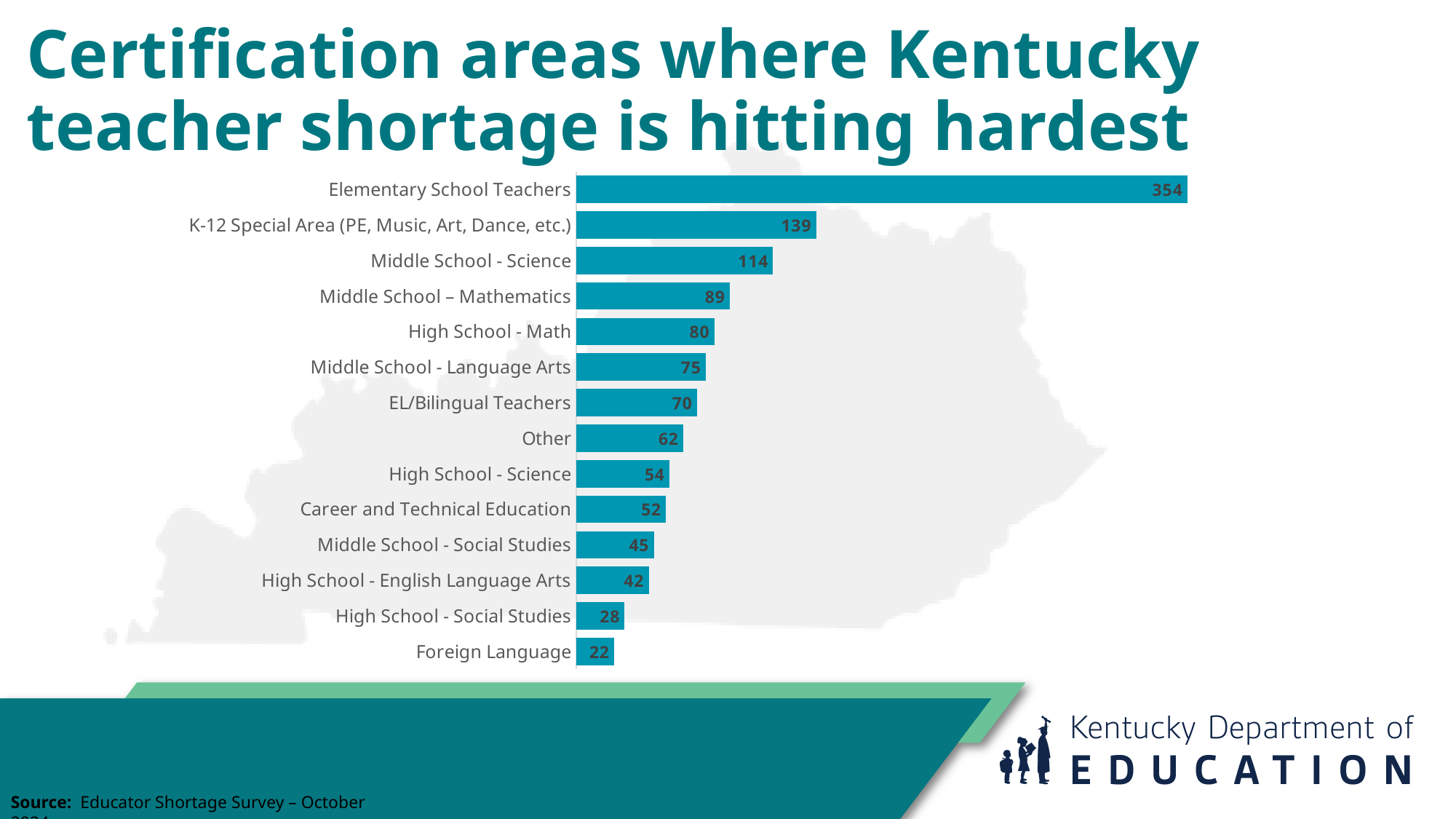
Which certification area has the lowest value? Foreign Language Which is larger, the value for Middle School – Mathematics or the value for Middle School - Language Arts? Middle School – Mathematics What is the value for EL/Bilingual Teachers? 70 What is the value for Middle School - Science? 114 What is the difference between the values for High School - Math and High School - Science? 26 How many certification areas are shown in the chart? 14 What is the difference between the values for Elementary School Teachers and K-12 Special Area (PE, Music, Art, Dance, etc.)? 215 What is the value for Elementary School Teachers? 354 What is the value for High School - Social Studies? 28 What kind of chart is shown on the slide? Bar chart Which certification area has the highest value? Elementary School Teachers